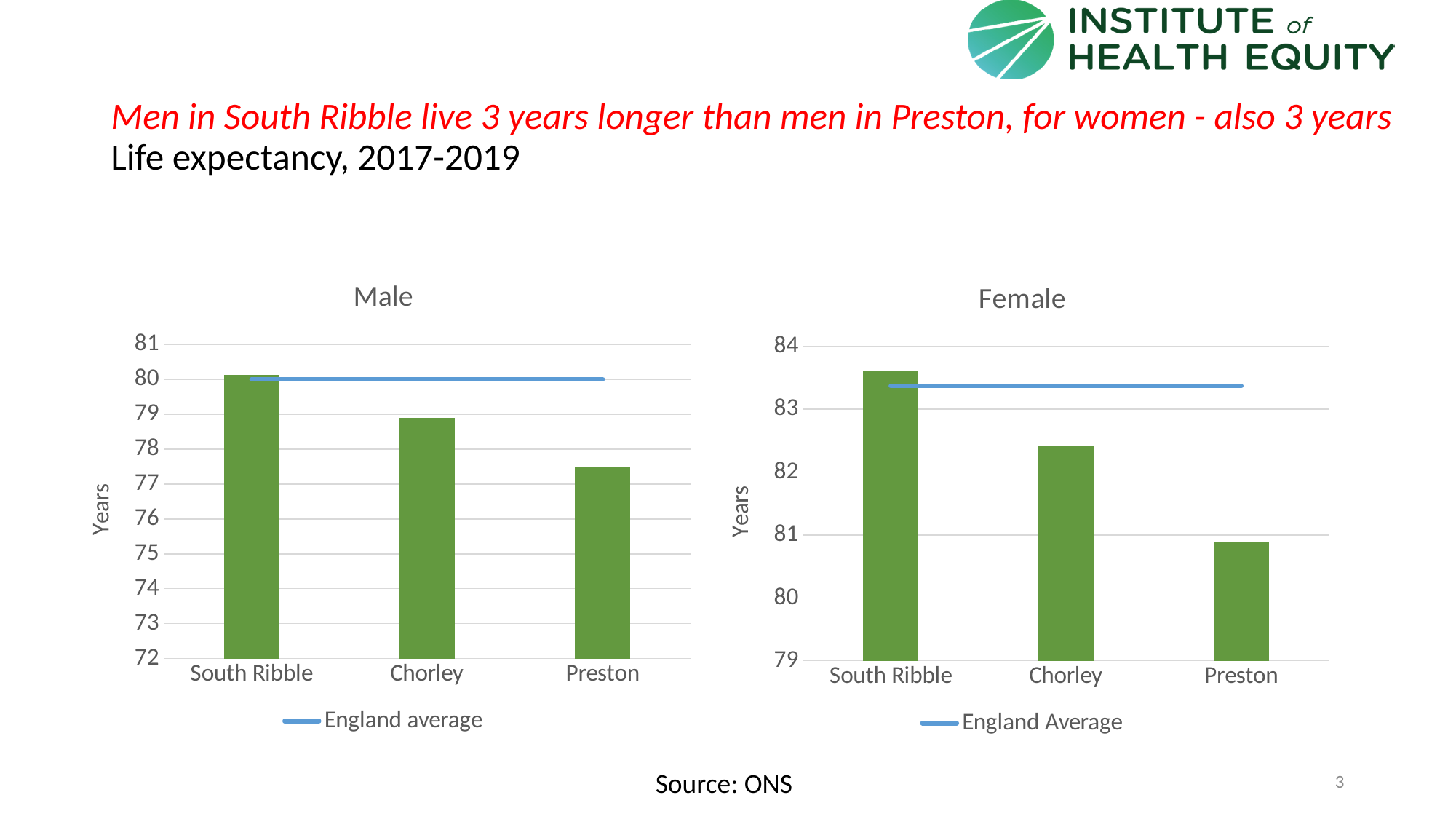
In the Male chart, which area has the highest life expectancy? South Ribble In the Male chart, which is larger, the value for Chorley or the value for Preston? Chorley In the Male chart, which area has the lowest life expectancy? Preston In the Male chart, is the value for Preston greater or less than 78? less What does the legend entry below the Male chart say? England average In the Female chart, is the value for Chorley greater or less than 82? greater What kind of chart is the Male chart? bar chart In the Female chart, which area has the lowest life expectancy? Preston In the Female chart, is the value for Preston greater or less than 82? less In the Female chart, do the values rise or fall from South Ribble to Preston? fall In the Female chart, which area has the highest life expectancy? South Ribble How many areas are shown on the x axis of the Female chart? 3